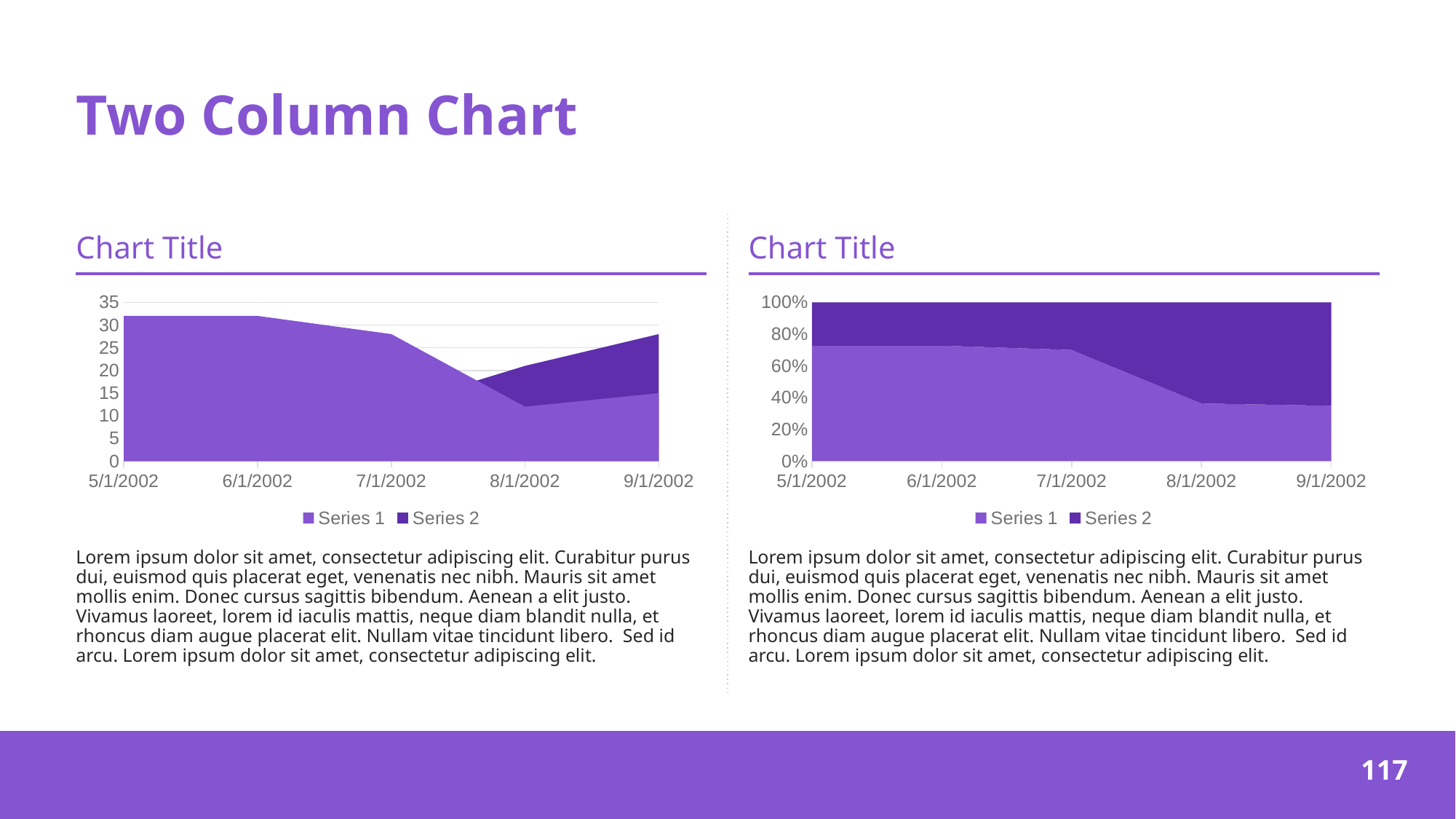
In the left chart, is the value for Series 1 at 8/1/2002 greater or less than 15? less In the left chart, is the value for Series 1 at 5/1/2002 greater or less than 25? greater What is the last date shown on the x axis of the left chart? 9/1/2002 What kind of chart is the chart on the right side of the slide? Stacked area chart (100%) In the right chart, is the share for Series 1 at 5/1/2002 greater or less than 60%? greater In the left chart, is Series 1 larger at 7/1/2002 or at 8/1/2002? 7/1/2002 How many series does the legend of the left chart list? 2 In the left chart, does Series 1 rise or fall from 5/1/2002 to 8/1/2002? fall How many dates are shown on the x axis of the right chart? 5 What kind of chart is the chart on the left side of the slide? Area chart In the left chart, at which date is Series 1 lowest? 8/1/2002